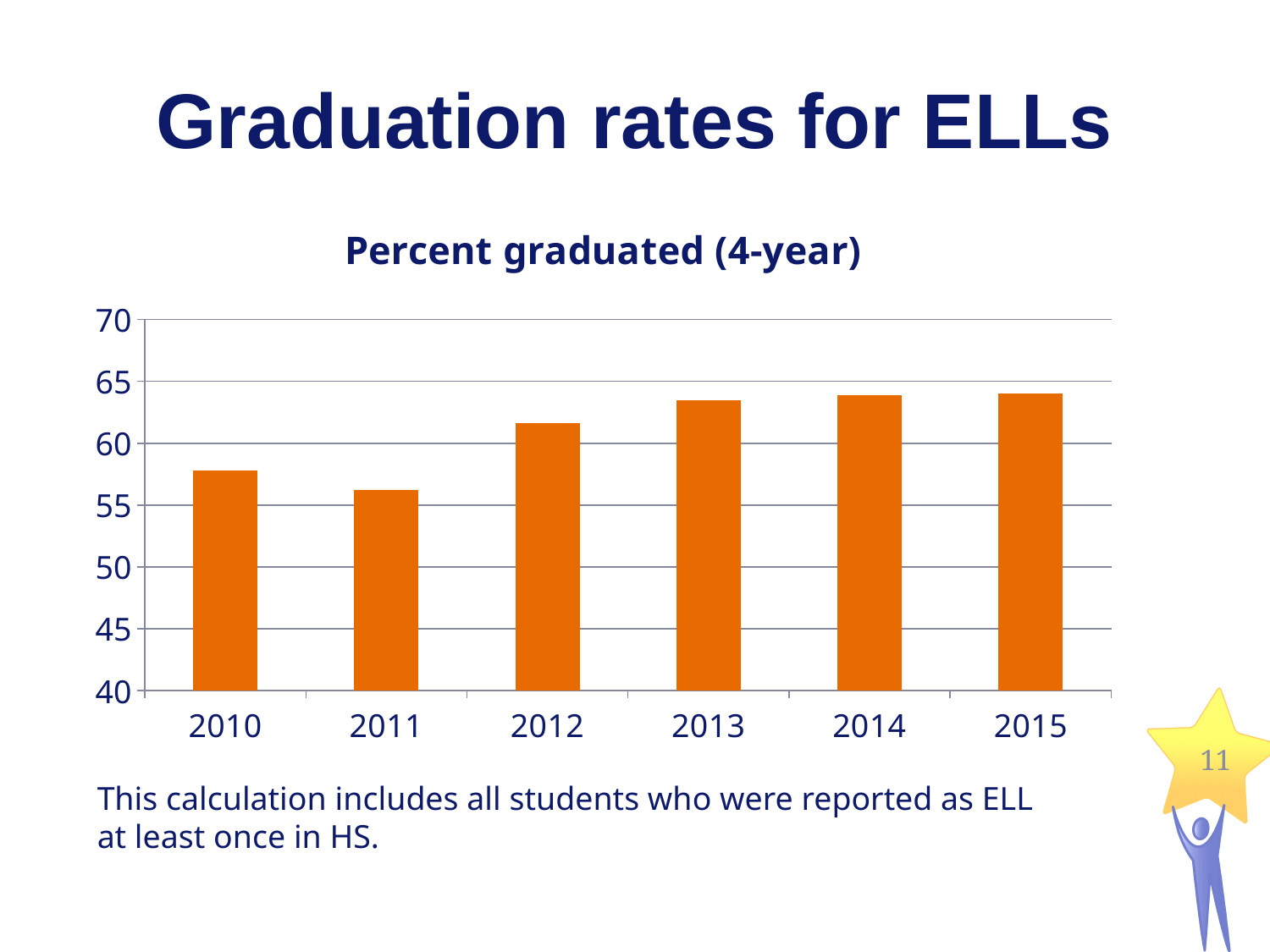
Which year has the higher percent graduated, 2010 or 2011? 2010 How many years are shown on the x axis of the chart? 6 Is the value for 2013 greater or less than 65? less What is the title of the chart? Percent graduated (4-year) Which year has the lowest percent graduated? 2011 Is the value for 2010 greater or less than 55? greater From 2011 to 2015, do the values rise or fall? rise Which year has the higher percent graduated, 2011 or 2013? 2013 What kind of chart is shown on the slide? Bar chart Is the value for 2015 greater or less than 60? greater